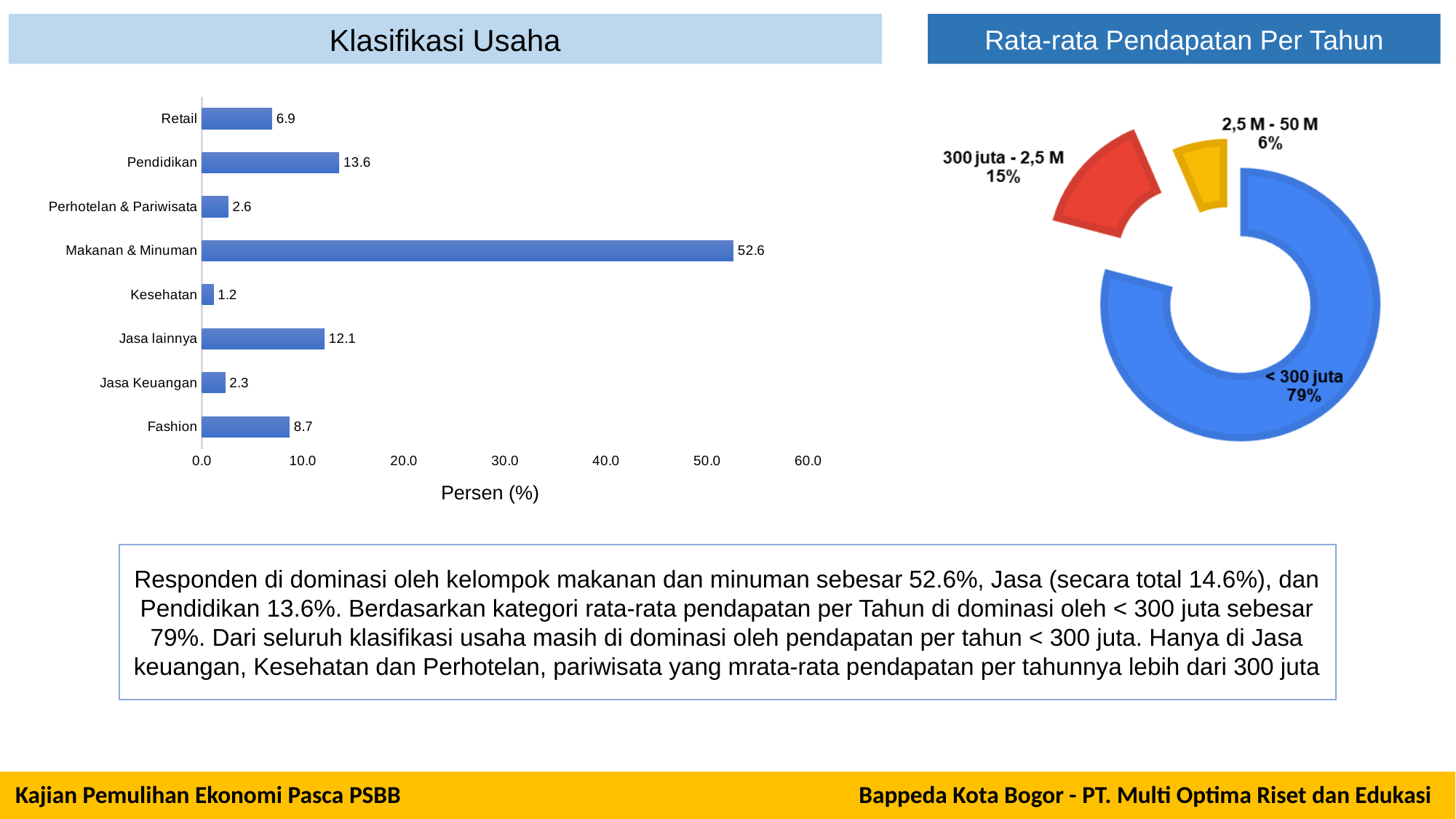
In the 'Rata-rata Pendapatan Per Tahun' chart, what share does '< 300 juta' have? 79% In the 'Klasifikasi Usaha' chart, what is the value for Pendidikan? 13.6 In the 'Klasifikasi Usaha' chart, what is the value for Makanan & Minuman? 52.6 What kind of chart is the 'Klasifikasi Usaha' chart? bar chart How many categories are shown in the 'Klasifikasi Usaha' chart? 8 In the 'Klasifikasi Usaha' chart, which category has the lowest value? Kesehatan In the 'Klasifikasi Usaha' chart, what is the difference between the values for Pendidikan and Jasa lainnya? 1.5 In the 'Klasifikasi Usaha' chart, which is larger, Retail or Fashion? Fashion What is the x-axis label of the 'Klasifikasi Usaha' chart? Persen (%) In the 'Klasifikasi Usaha' chart, which category has the highest value? Makanan & Minuman In the 'Klasifikasi Usaha' chart, is the value for Makanan & Minuman greater or less than 50.0? greater In the 'Rata-rata Pendapatan Per Tahun' chart, which category has the smallest share? 2,5 M - 50 M